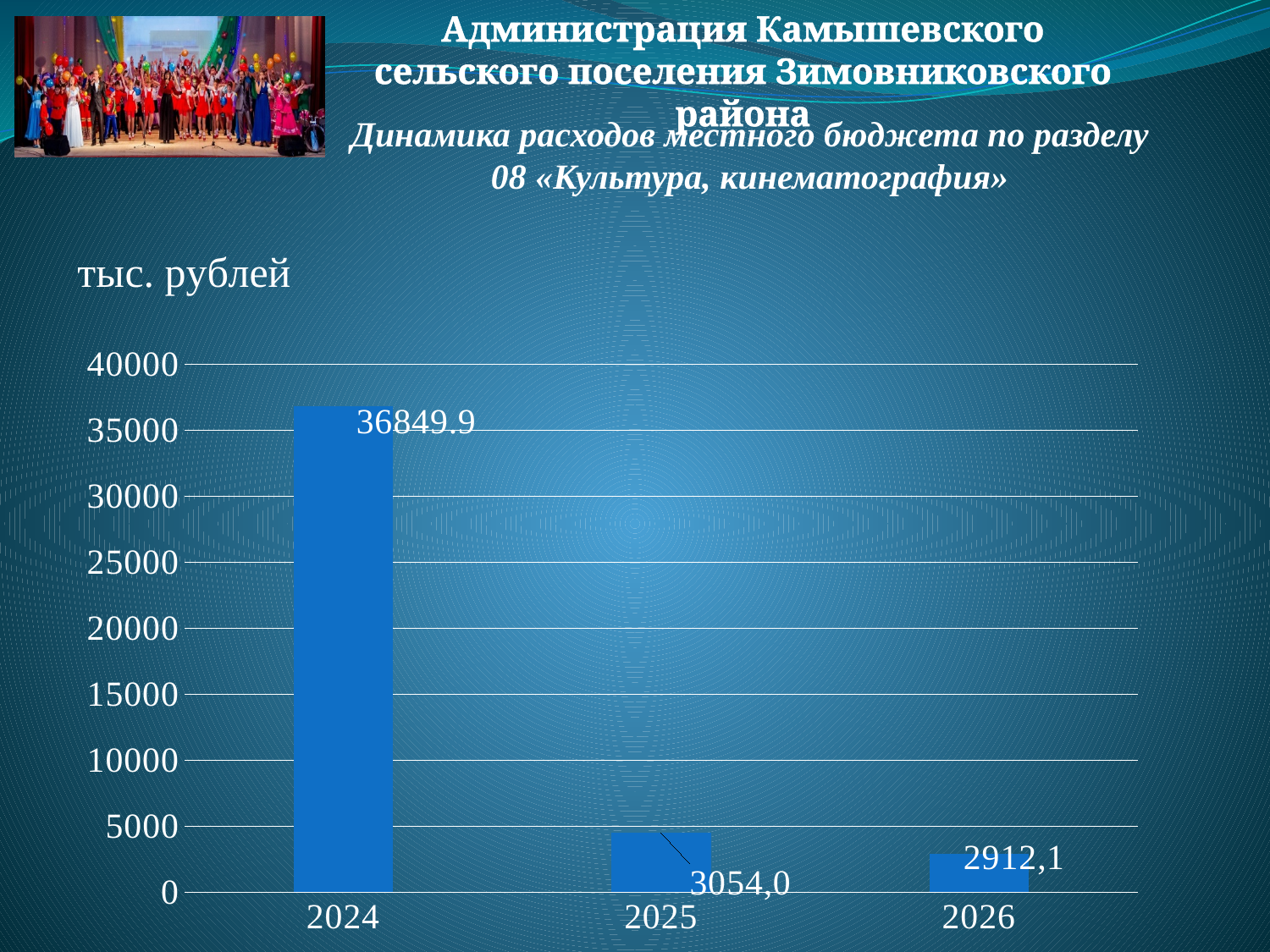
Which year has the highest value? 2024 What is the difference between the values for 2025 and 2026? 141,9 What is the value for 2024? 36849.9 Do the values rise or fall from 2024 to 2026? fall Which is larger, the value for 2024 or the value for 2025? 2024 What is the value for 2026? 2912,1 What is the value for 2025? 3054,0 What type of chart is shown on the slide? bar chart In what units are the values on the chart expressed? тыс. рублей Which year has the lowest value? 2026 Is the value for 2024 greater or less than 35000? greater How many years are shown on the x axis? 3